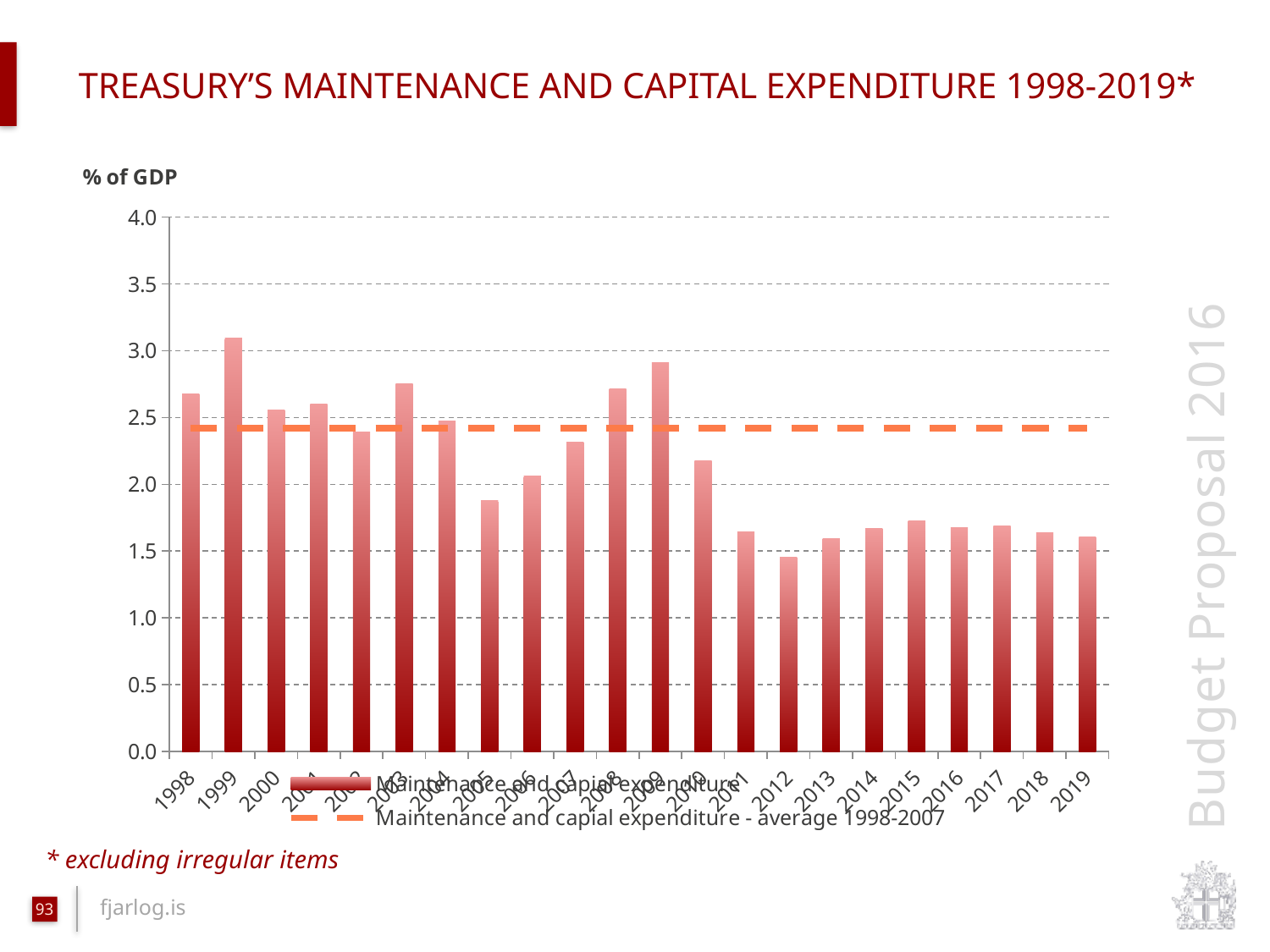
What unit is shown on the y axis label of the chart? % of GDP Is the value for 2009 greater or less than 2.5? greater What kind of chart is shown on the slide? bar chart Is the value for 2011 greater or less than 2.0? less How many series does the legend list? 2 Which year has the larger value, 1999 or 2009? 1999 Is the value for 2005 greater or less than 2.0? less How many years (bars) are plotted on the chart? 22 Which year has the highest maintenance and capital expenditure as % of GDP? 1999 Which year has the lowest maintenance and capital expenditure as % of GDP? 2012 Overall, do the values rise or fall from 1998 to 2019? fall